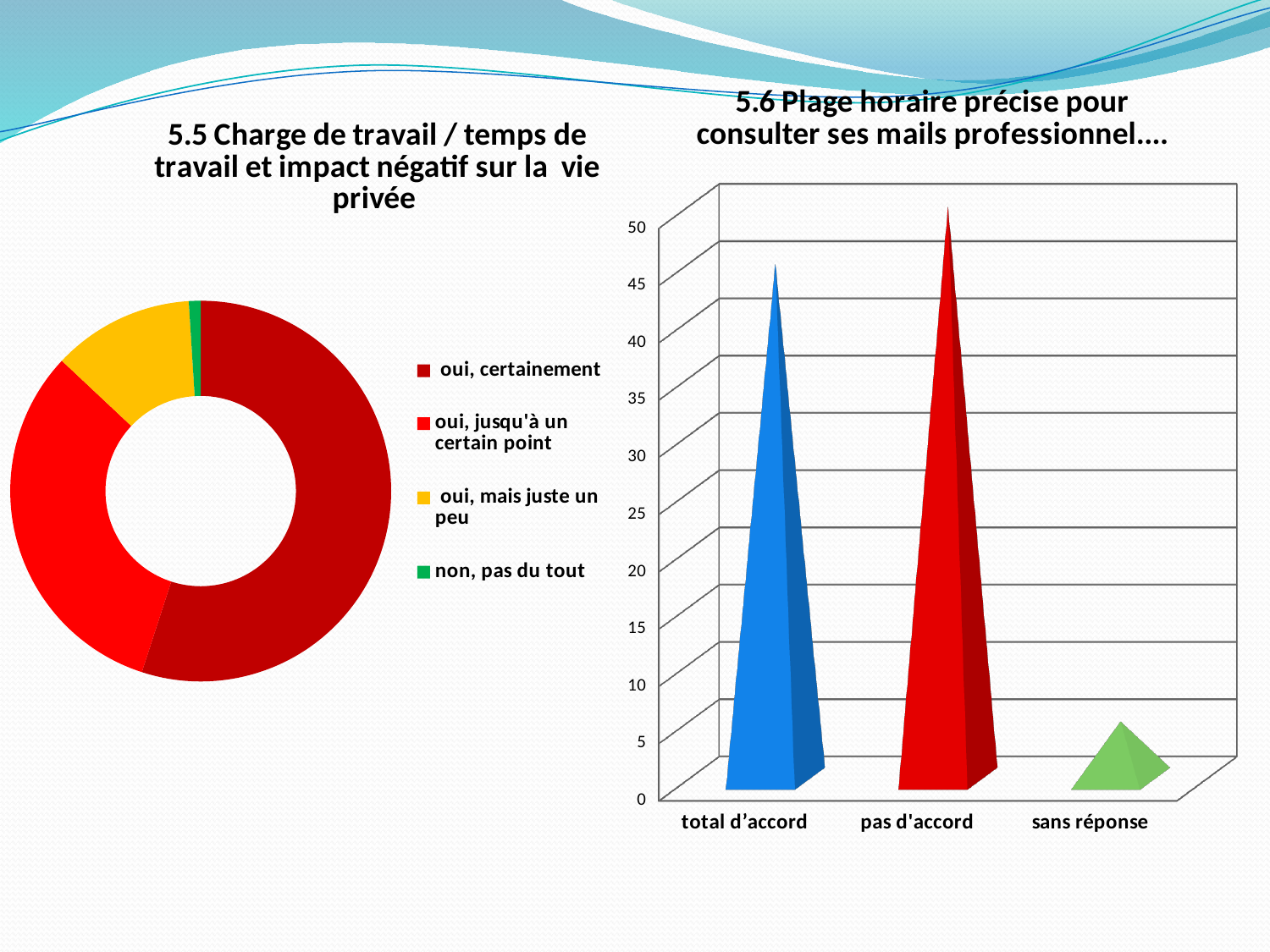
In the chart titled '5.5 Charge de travail / temps de travail et impact négatif sur la vie privée', which category has the largest slice? oui, certainement In the chart titled '5.5 Charge de travail / temps de travail et impact négatif sur la vie privée', what colour is the slice for 'oui, mais juste un peu'? yellow In the chart titled '5.6 Plage horaire précise pour consulter ses mails professionnel....', which is larger, the value for 'total d'accord' or the value for 'sans réponse'? total d'accord In the chart titled '5.6 Plage horaire précise pour consulter ses mails professionnel....', how many categories are shown on the x axis? 3 In the chart titled '5.6 Plage horaire précise pour consulter ses mails professionnel....', which category has the lowest value? sans réponse In the chart titled '5.5 Charge de travail / temps de travail et impact négatif sur la vie privée', what kind of chart is shown? doughnut chart In the chart titled '5.5 Charge de travail / temps de travail et impact négatif sur la vie privée', which category has the smallest slice? non, pas du tout In the chart titled '5.6 Plage horaire précise pour consulter ses mails professionnel....', what kind of chart is shown? bar chart In the chart titled '5.6 Plage horaire précise pour consulter ses mails professionnel....', which category has the highest value? pas d'accord In the chart titled '5.6 Plage horaire précise pour consulter ses mails professionnel....', is the value for 'total d'accord' greater or less than 40? greater In the chart titled '5.5 Charge de travail / temps de travail et impact négatif sur la vie privée', how many categories does the legend list? 4 In the chart titled '5.6 Plage horaire précise pour consulter ses mails professionnel....', is the value for 'sans réponse' greater or less than 10? less